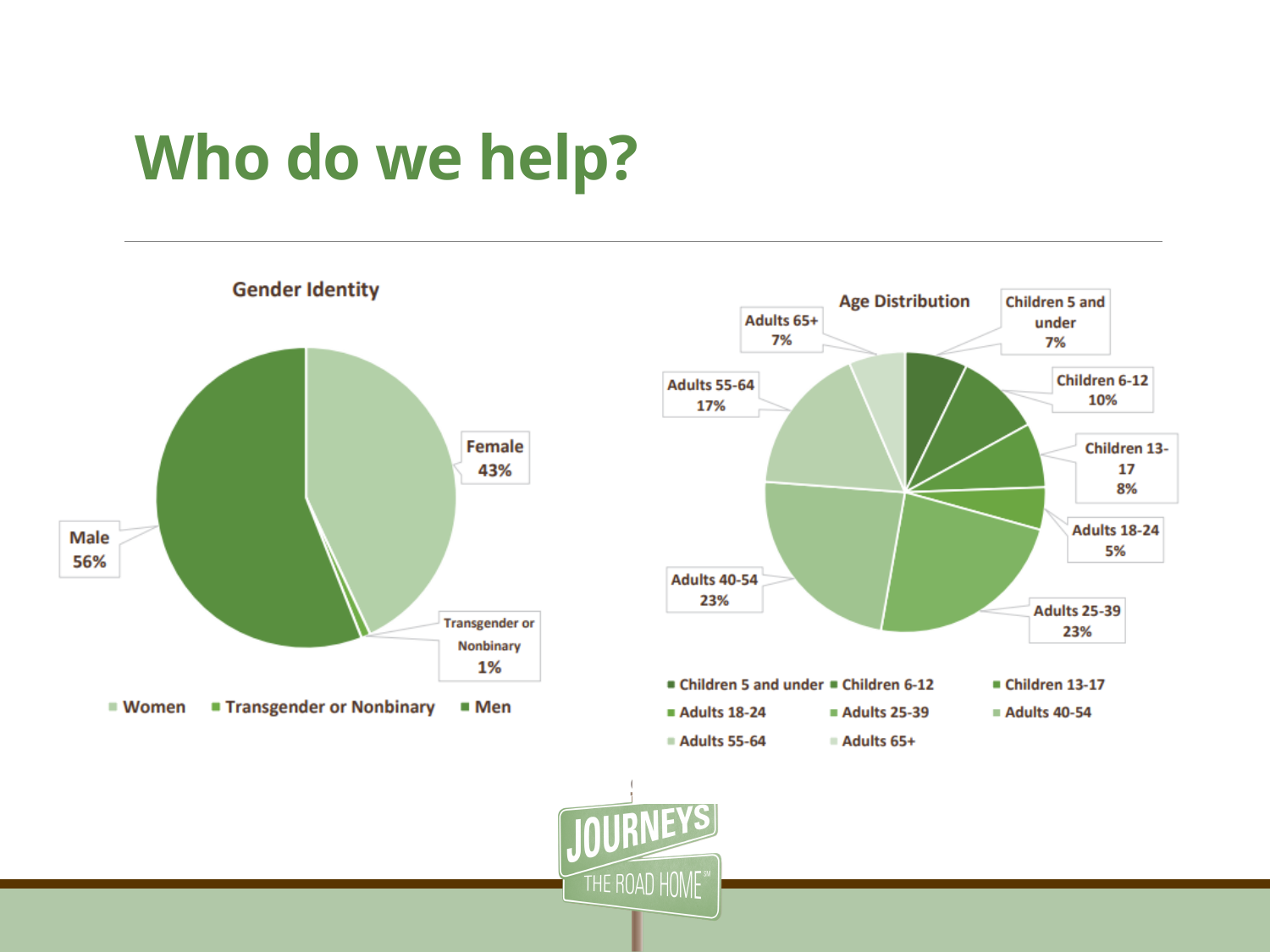
In the Gender Identity chart, what percentage is labelled Transgender or Nonbinary? 1% In the Gender Identity chart, what percentage is labelled Male? 56% In the Age Distribution chart, which is larger, Children 13-17 or Adults 65+? Children 13-17 In the Age Distribution chart, what is the difference between Adults 40-54 and Adults 55-64? 6% How many age groups does the Age Distribution chart's legend list? 8 In the Age Distribution chart, what percentage is labelled Children 6-12? 10% What kind of chart is the Gender Identity chart? Pie chart In the Gender Identity chart, what percentage is labelled Female? 43% In the Gender Identity chart, what is the difference between the Male and Female percentages? 13% In the Age Distribution chart, what percentage is labelled Adults 55-64? 17% In the Gender Identity chart, which slice is the largest? Male In the Age Distribution chart, which age group has the smallest share? Adults 18-24